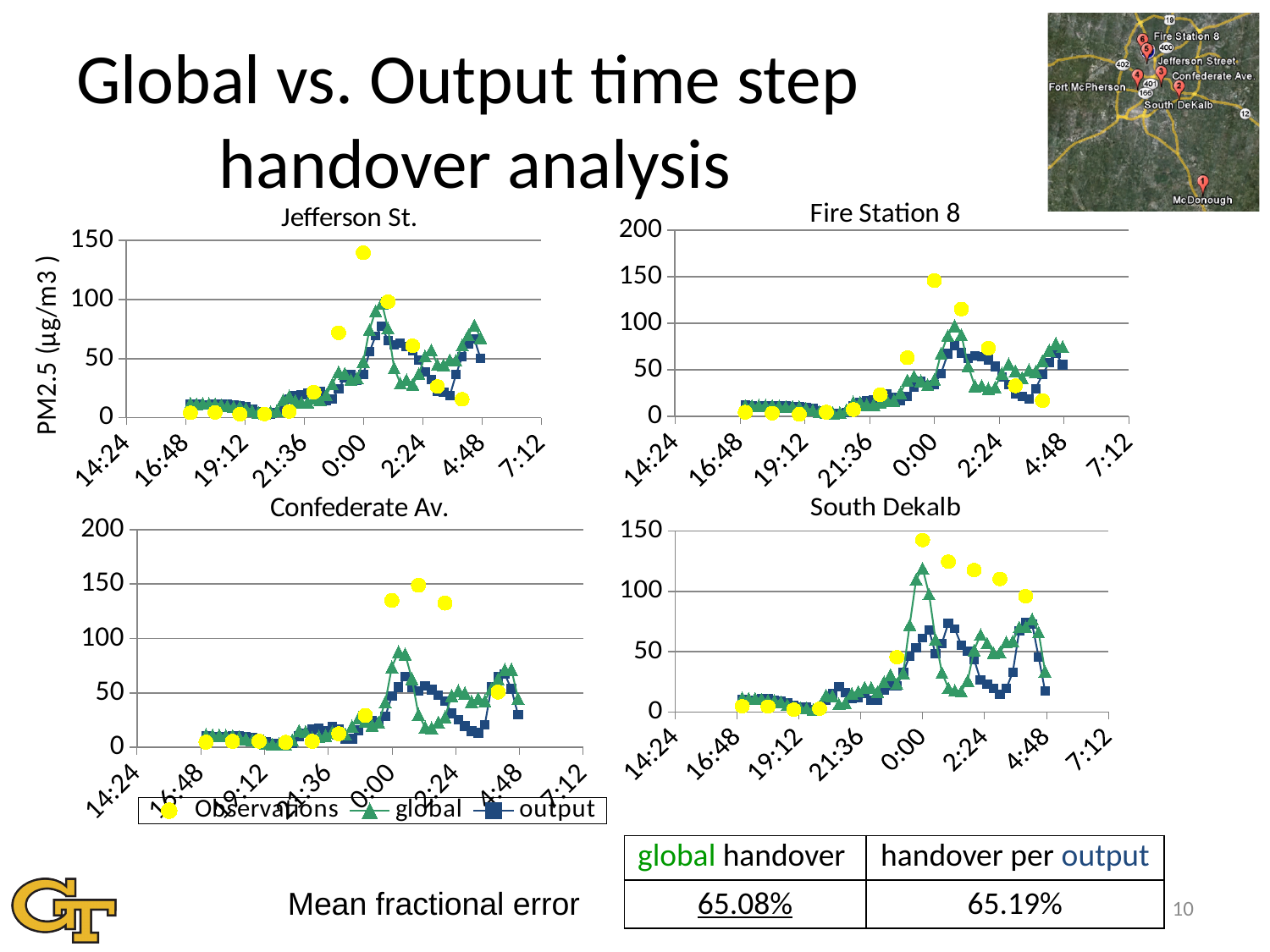
In the Fire Station 8 chart, is the highest Observations value greater or less than 100? greater How many series does the legend at the bottom of the slide list? 3 What kind of chart is the Jefferson St. chart? line chart In the Confederate Av. chart, is the highest global value greater or less than 100? less In the Fire Station 8 chart, is the highest output value greater or less than 100? less What are the three series named in the legend? Observations, global, output What is the y-axis label on the Jefferson St. chart? PM2.5 (µg/m3 ) How many charts are shown on the slide? 4